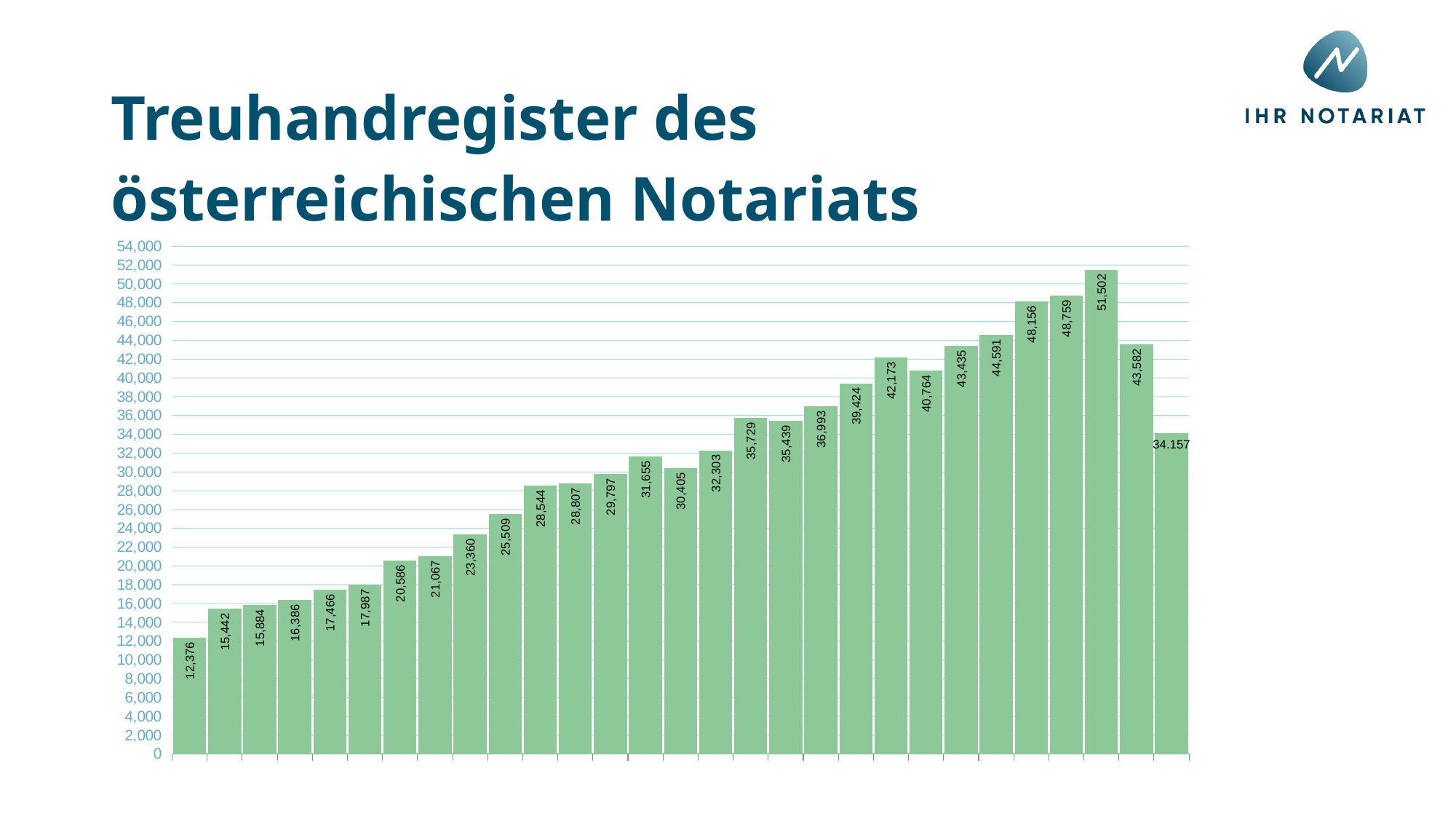
What colour are the bars in the chart? green What is the title of the slide containing the chart? Treuhandregister des österreichischen Notariats Is the value of the tallest bar greater or less than 50,000? greater What is the value of the last (rightmost) bar in the chart? 34.157 What is the difference between the tallest bar (51,502) and the shortest bar (12,376)? 39,126 What is the value of the tallest bar in the chart? 51,502 What is the value of the first (leftmost) bar in the chart? 12,376 Which is larger, the second-to-last bar or the last bar? the second-to-last bar (43,582) What kind of chart is shown on the slide? bar chart What is the value of the shortest bar in the chart? 12,376 How many bars are plotted in the chart? 29 Do the bar values generally rise or fall from left to right before the final two bars? rise